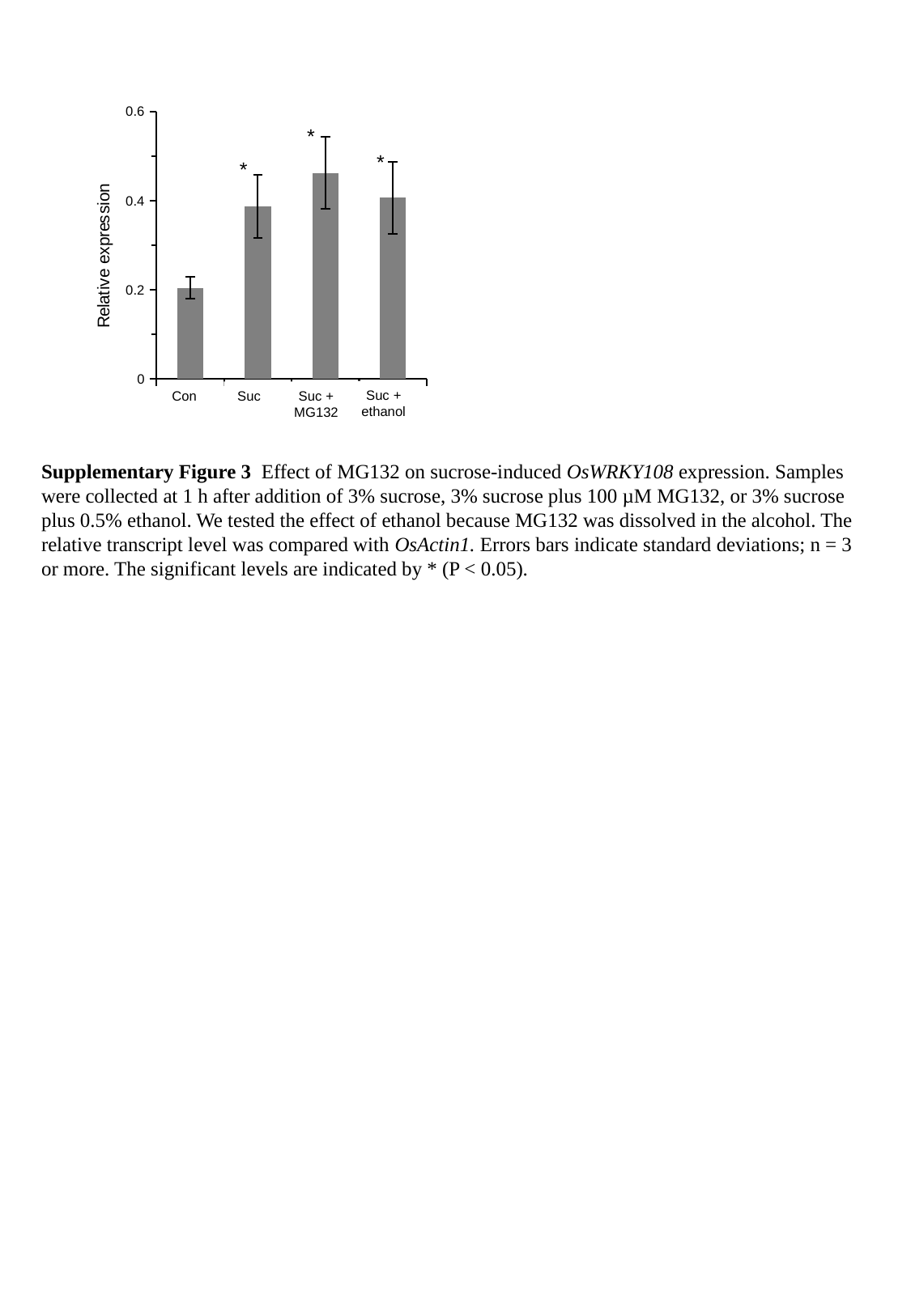
Which category has the highest relative expression? Suc + MG132 Which is larger, the value for Con or the value for Suc? Suc How many bars in the chart are marked with an asterisk? 3 Is the value for Con greater or less than 0.4? less Is the value for Suc greater or less than 0.2? greater Which category has the lowest relative expression? Con How many categories are plotted on the x axis of the chart? 4 Is the value for Suc + ethanol greater or less than 0.6? less What kind of chart is shown on the slide? bar chart What is the label of the y axis of the chart? Relative expression Which is larger, the value for Suc or the value for Suc + MG132? Suc + MG132